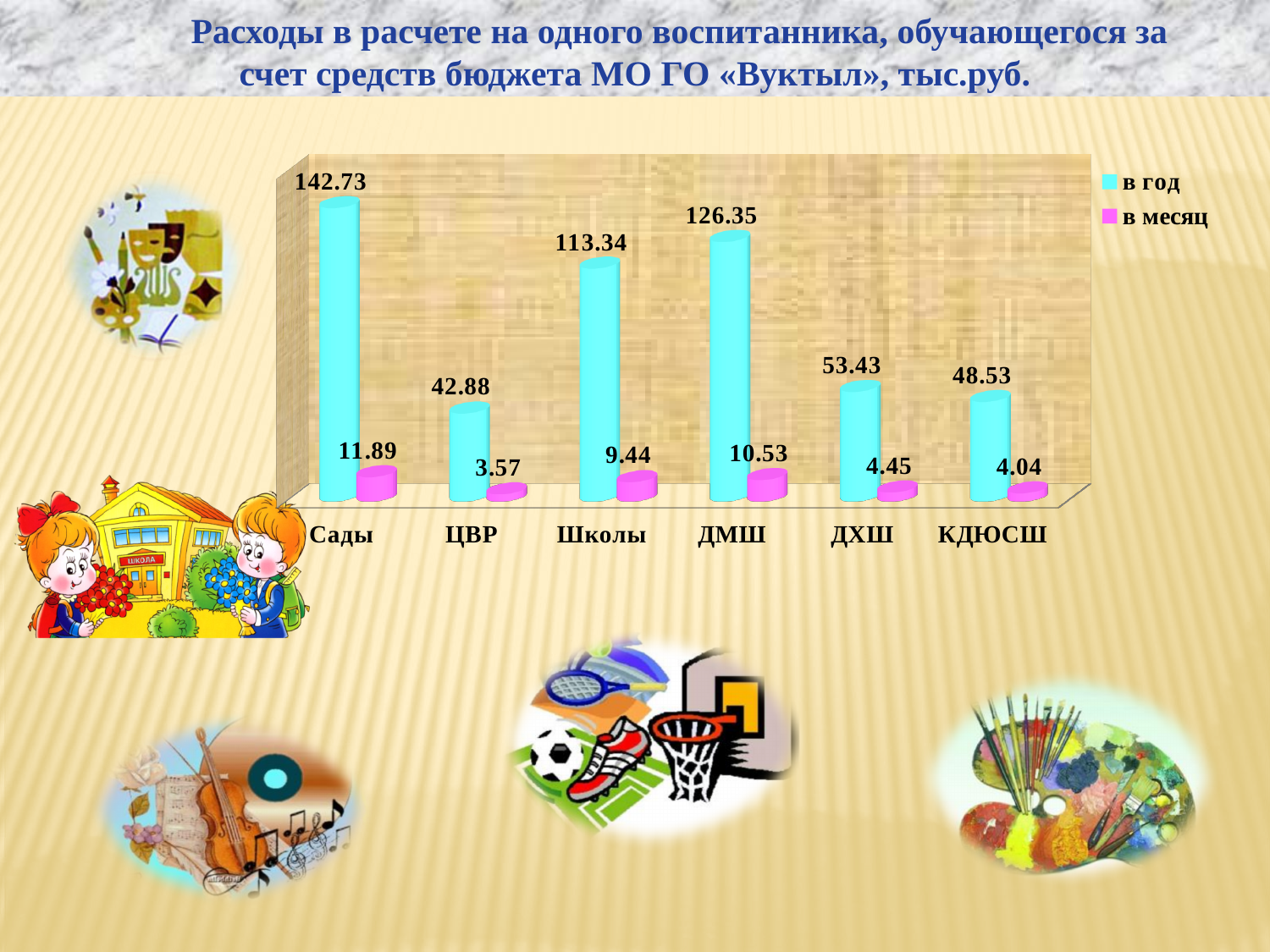
Which colour represents the series «в месяц» in the legend? Pink Which category has the highest value in the series «в год»? Сады What is the difference between the «в месяц» values for Сады and ЦВР? 8.32 What is the difference between the «в год» values for Сады and ДМШ? 16.38 What is the value for ДМШ in the series «в месяц»? 10.53 What kind of chart is shown on the slide? Bar chart How many categories are shown on the x axis? 6 How many series does the legend list? 2 Which category has the lowest value in the series «в месяц»? ЦВР What is the value for Сады in the series «в год»? 142.73 What is the value for ЦВР in the series «в год»? 42.88 Which is larger in the series «в год»: ДХШ or КДЮСШ? ДХШ